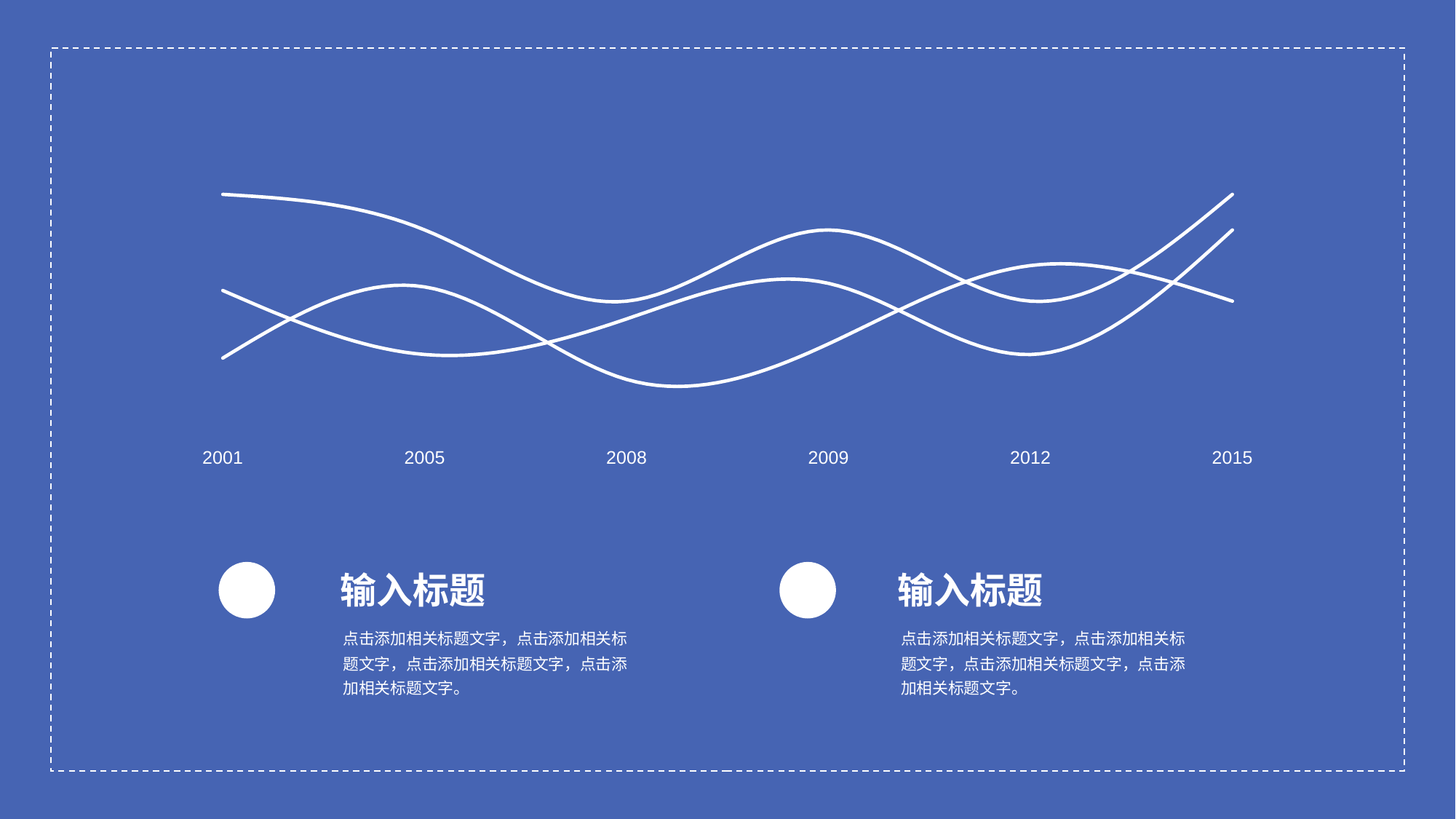
What is the first year label on the x axis of the chart? 2001 Which year label comes immediately after 2008 on the x axis? 2009 How many year labels are shown along the x axis of the chart? 6 Does the line that starts lowest at 2001 rise or fall between 2001 and 2005? rise How many lines are plotted on the chart? 3 Does the line that starts highest at 2001 rise or fall between 2001 and 2005? fall What kind of chart is shown on the slide? line chart What is the last year label on the x axis of the chart? 2015